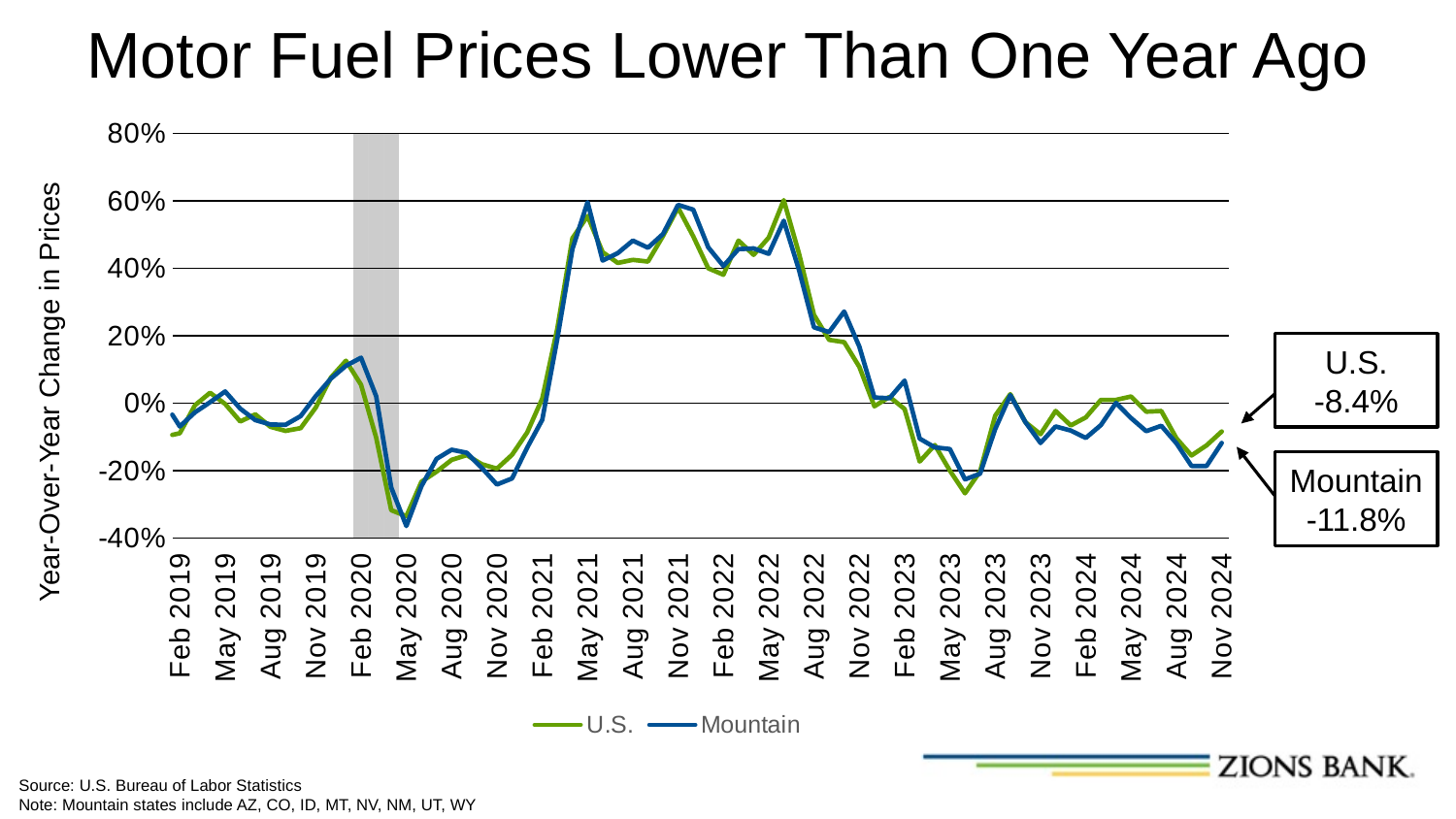
How many series does the legend list? 2 By how many percentage points does the U.S. value differ from the Mountain value in Nov 2024? 3.4 percentage points What is the title of the chart? Motor Fuel Prices Lower Than One Year Ago Is the U.S. value in May 2023 greater or less than 0%? less Is the U.S. value in May 2021 greater or less than 40%? greater Between May 2022 and Feb 2023, do the U.S. values rise or fall? fall What is the year-over-year change in motor fuel prices for the Mountain states in Nov 2024? -11.8% What is the label on the vertical axis? Year-Over-Year Change in Prices Is the Mountain value in May 2020 greater or less than -20%? less What kind of chart is shown on the slide? Line chart What is the year-over-year change in motor fuel prices for the U.S. in Nov 2024? -8.4% In Nov 2024, which series has the higher year-over-year change in prices, U.S. or Mountain? U.S.